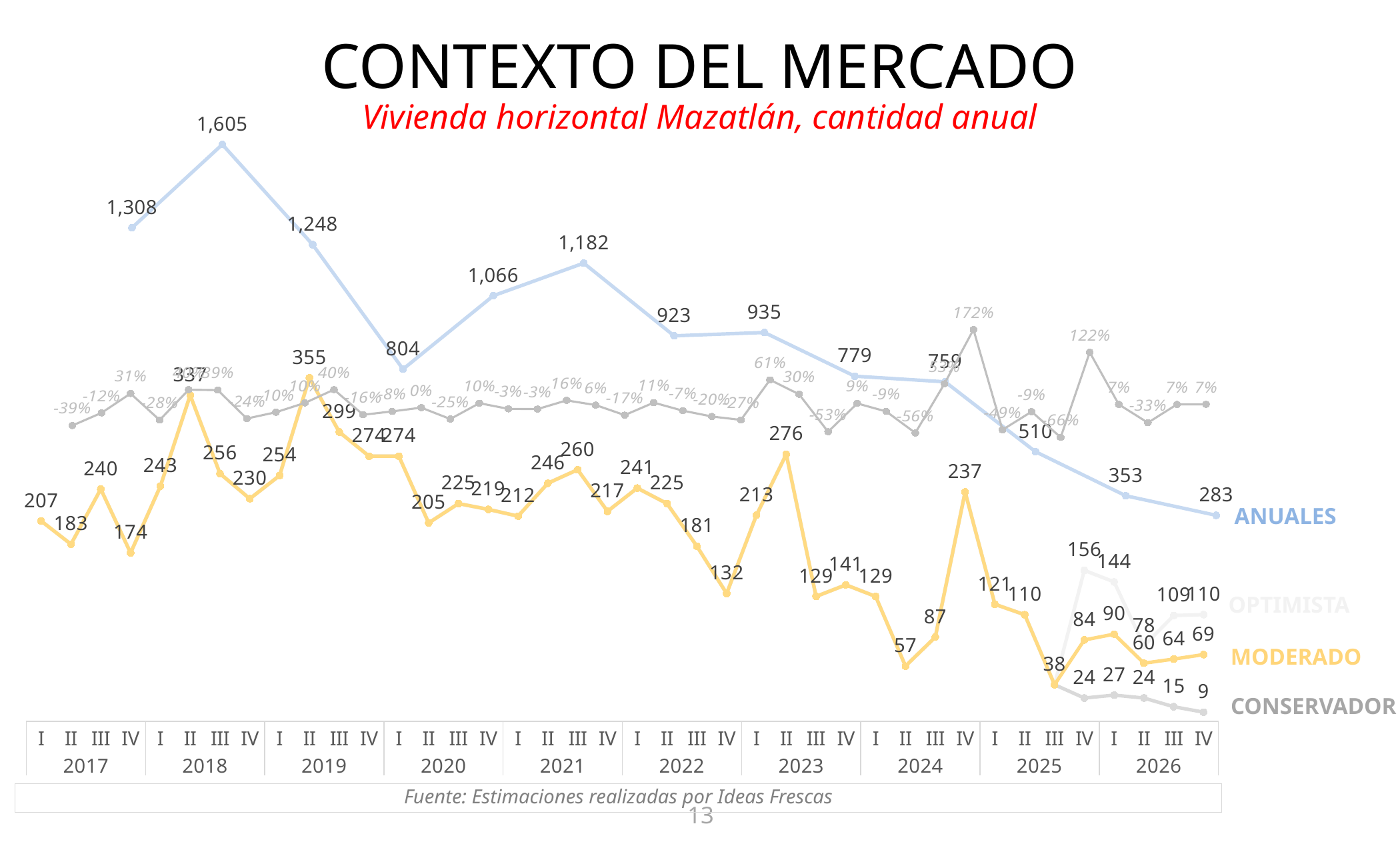
On the MODERADO line, which is larger: the value for quarter II of 2018 or quarter II of 2019? quarter II of 2019 (355) What is the OPTIMISTA value for quarter IV of 2026? 110 Does the ANUALES line rise or fall from its 1,182 point to its final 283 point? fall What is the highest value labelled on the ANUALES line? 1,605 What is the difference between the MODERADO values for quarter IV of 2024 (237) and quarter III of 2024 (87)? 150 What is the lowest value on the MODERADO line? 38 What is the difference between the OPTIMISTA value (110) and the MODERADO value (69) in quarter IV of 2026? 41 What is the last (rightmost) value labelled on the ANUALES line? 283 What kind of chart is shown on the slide? line chart How many years are shown on the x axis? 10 What is the highest value on the MODERADO line? 355 What is the CONSERVADOR value for quarter IV of 2026? 9